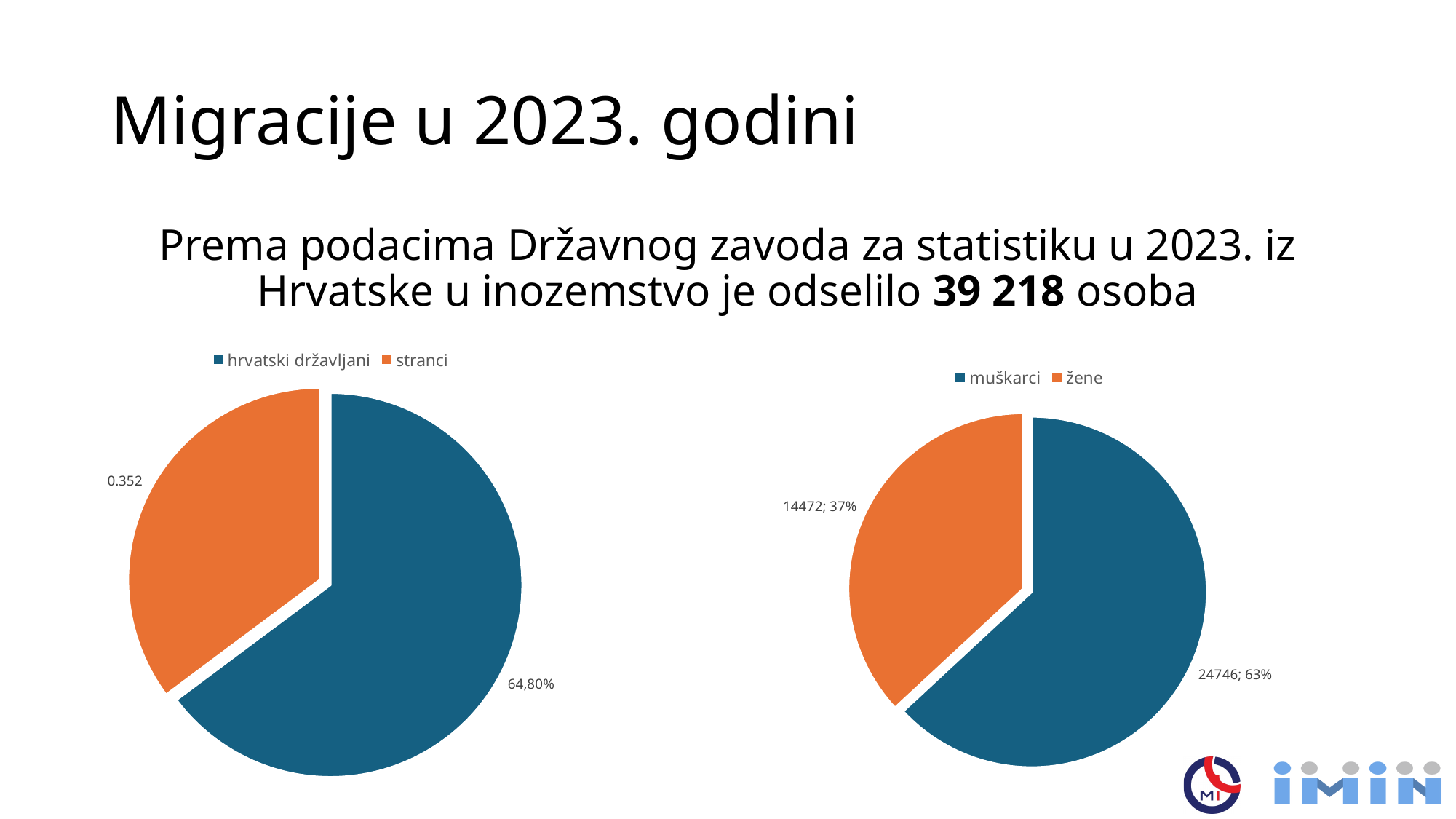
In the right pie chart, what value is shown for žene? 14472 How many entries does the legend of the left pie chart list? 2 In the left pie chart, which slice is larger: hrvatski državljani or stranci? hrvatski državljani In the left pie chart, what label is shown for the hrvatski državljani slice? 64,80% In the left pie chart, what label is shown for the stranci slice? 0.352 In the right pie chart, what share of the pie does the muškarci slice represent? 63% In the right pie chart, what is the difference between the muškarci and žene values? 10274 In the right pie chart, which category has the largest slice? muškarci What kind of chart is the left chart on the slide? pie chart In the right pie chart, what value is shown for muškarci? 24746 In the right pie chart, what share of the pie does the žene slice represent? 37% In the left pie chart, what colour is the stranci slice? orange